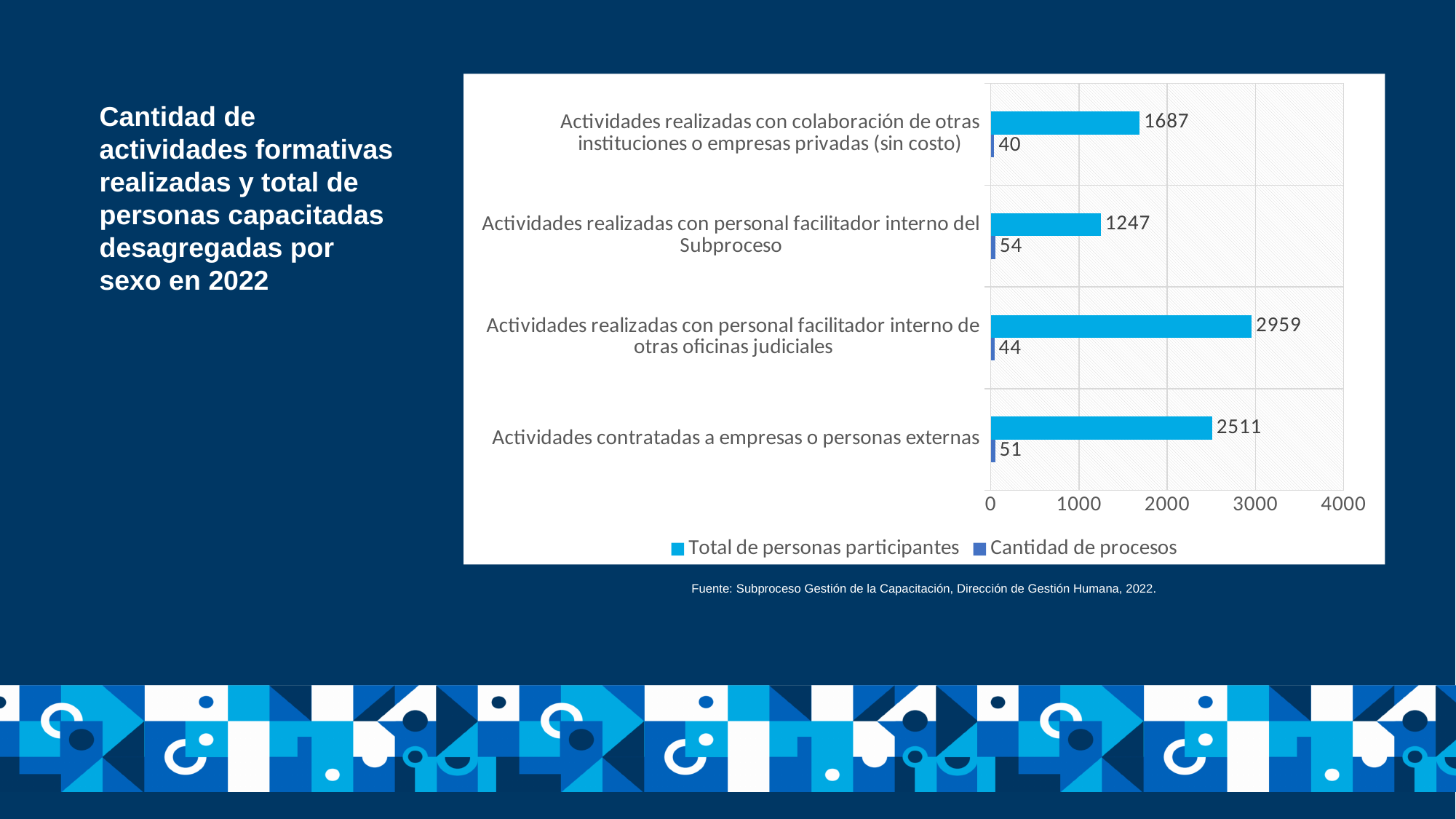
Is the 'Total de personas participantes' value for 'Actividades contratadas a empresas o personas externas' greater or less than 2000? greater What is the value of 'Cantidad de procesos' for 'Actividades realizadas con personal facilitador interno del Subproceso'? 54 What is the value of 'Total de personas participantes' for 'Actividades realizadas con colaboración de otras instituciones o empresas privadas (sin costo)'? 1687 What is the value of 'Cantidad de procesos' for 'Actividades contratadas a empresas o personas externas'? 51 What is the value of 'Total de personas participantes' for 'Actividades realizadas con personal facilitador interno de otras oficinas judiciales'? 2959 Which category has the highest value for 'Total de personas participantes'? Actividades realizadas con personal facilitador interno de otras oficinas judiciales What kind of chart is shown on the slide? bar chart What is the difference in 'Total de personas participantes' between 'Actividades realizadas con personal facilitador interno de otras oficinas judiciales' and 'Actividades contratadas a empresas o personas externas'? 448 How many categories are shown on the chart? 4 Which is larger for 'Total de personas participantes': 'Actividades realizadas con colaboración de otras instituciones o empresas privadas (sin costo)' or 'Actividades realizadas con personal facilitador interno del Subproceso'? Actividades realizadas con colaboración de otras instituciones o empresas privadas (sin costo) Which category has the lowest value for 'Cantidad de procesos'? Actividades realizadas con colaboración de otras instituciones o empresas privadas (sin costo) How many series does the legend list? 2